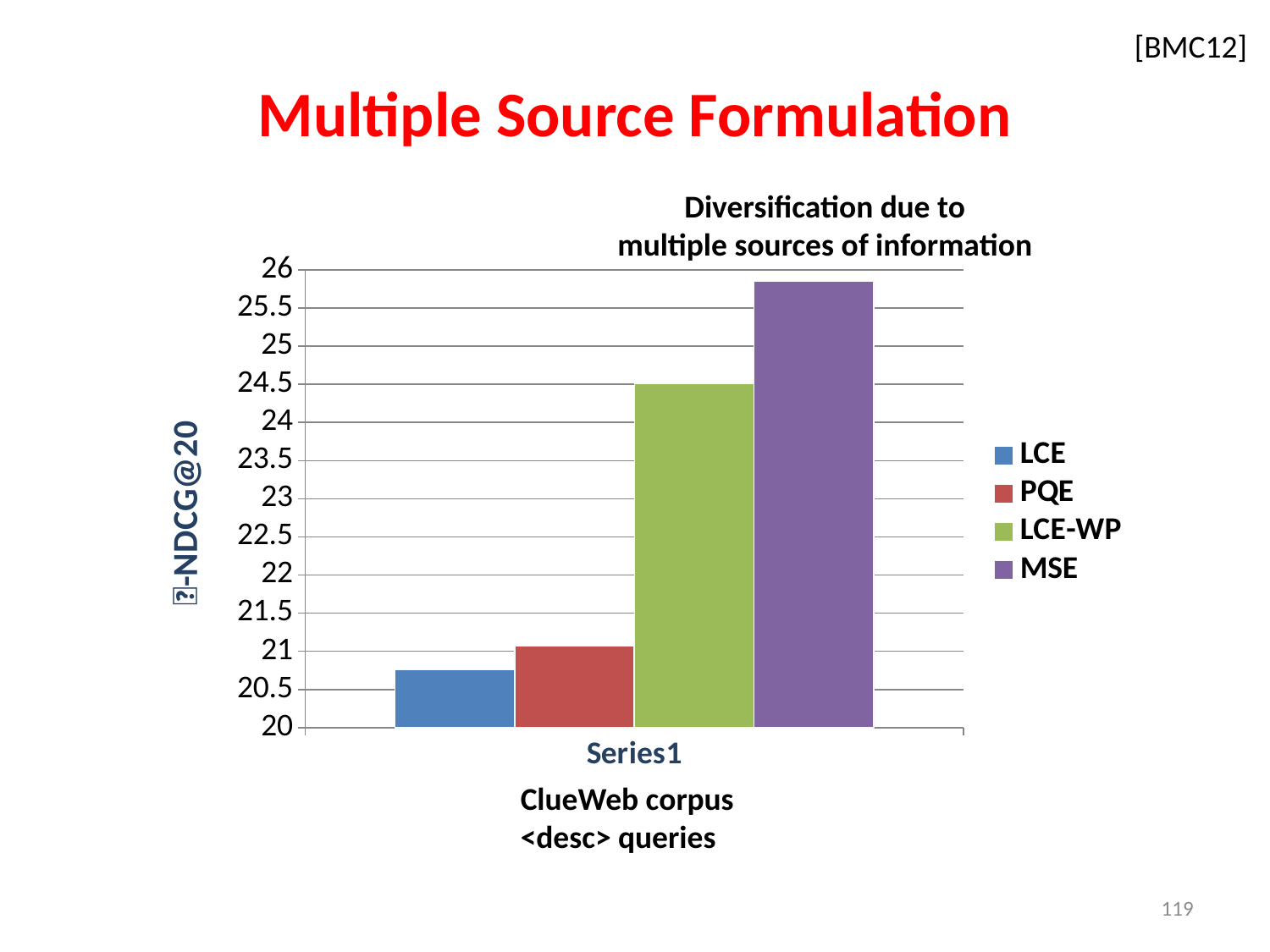
Is the value for LCE-WP greater or less than 24? greater Which series has the lowest bar? LCE How many categories are shown on the x axis? 1 Which is larger, the value for LCE-WP or the value for MSE? MSE Which series has the highest bar? MSE What kind of chart is shown on the slide? bar chart What is the title of the chart? Diversification due to multiple sources of information Is the value for PQE greater or less than 21.5? less How many series does the legend list? 4 Which is larger, the value for LCE or the value for PQE? PQE Is the value for LCE greater or less than 21? less